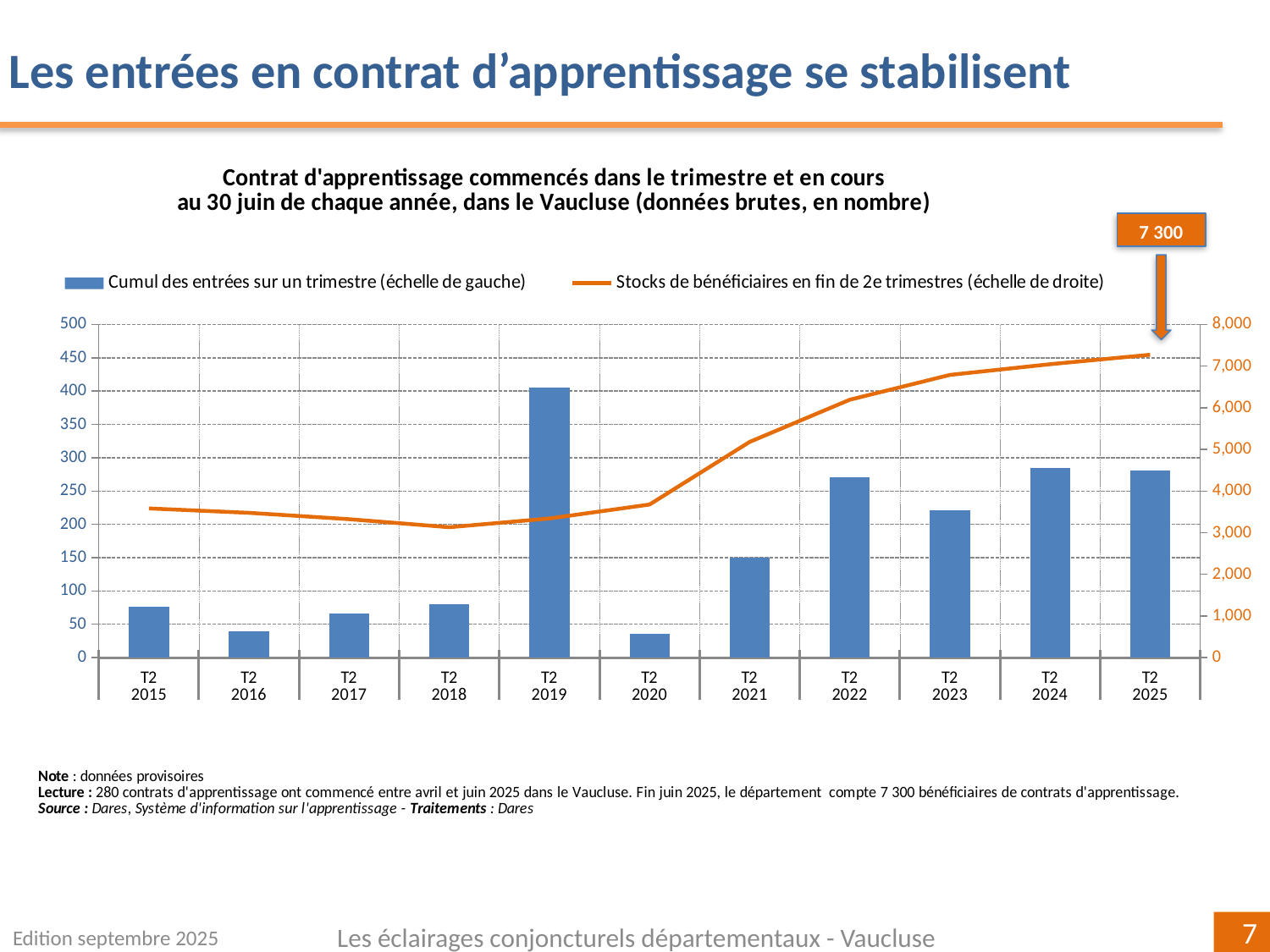
Is the bar for T2 2021 greater or less than 200? less What kind of chart is shown on the slide? A combination bar and line chart Is the bar for T2 2019 greater or less than 350? greater Does the line 'Stocks de bénéficiaires en fin de 2e trimestres' rise or fall between T2 2018 and T2 2025? It rises Which quarter has the highest bar for 'Cumul des entrées sur un trimestre'? T2 2019 How many quarters (categories) are shown on the x axis? 11 Is the bar for T2 2022 greater or less than 250? greater What colour is the line series on the chart? Orange How many series does the legend list? 2 Which series is plotted on the right-hand axis (échelle de droite)? Stocks de bénéficiaires en fin de 2e trimestres What value is labelled for the stock of beneficiaries at T2 2025? 7 300 Which bar is taller, T2 2022 or T2 2023? T2 2022